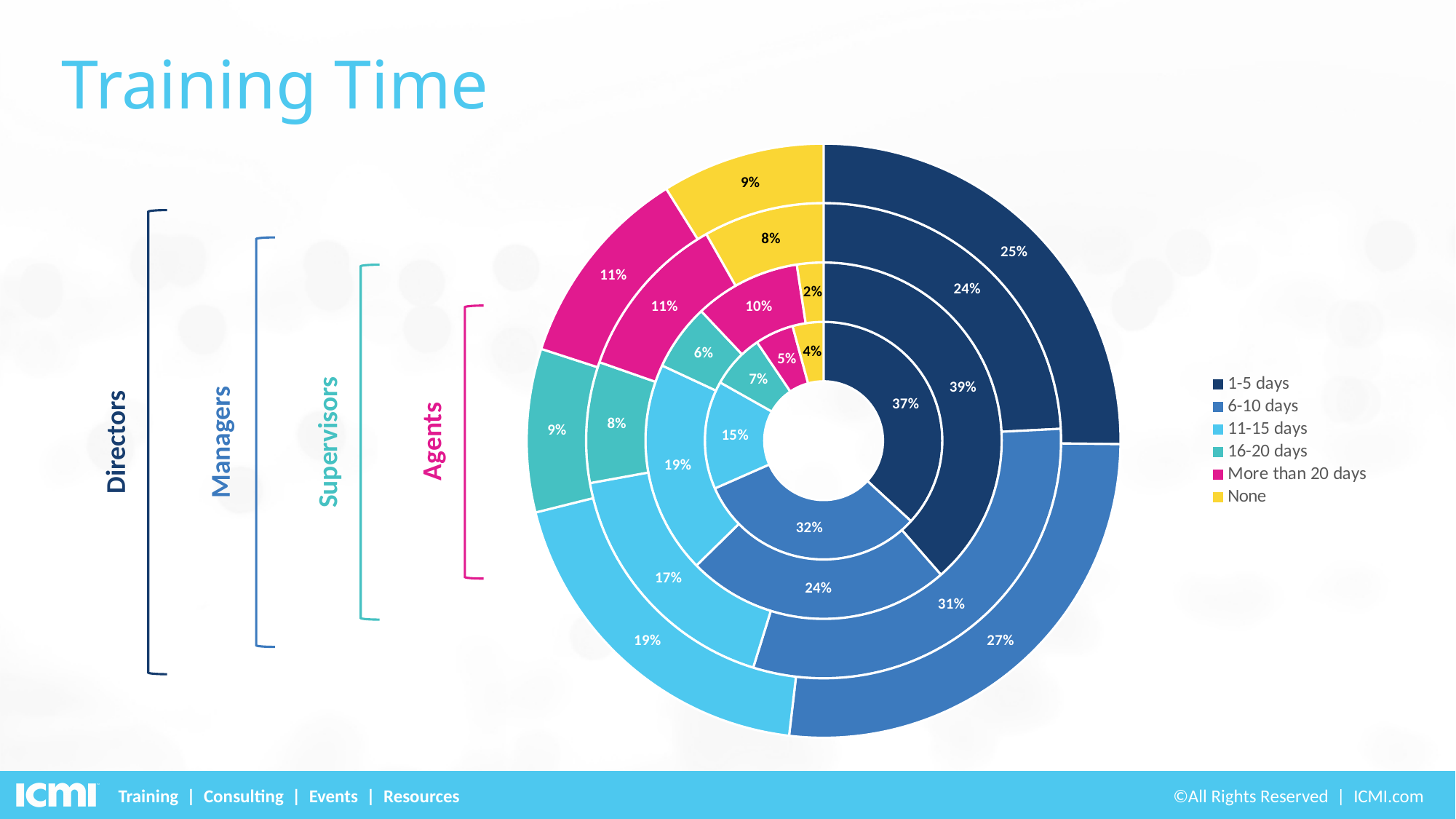
What is the difference between the 1-5 days share for Supervisors and for Directors? 14% What percentage of Managers have more than 20 days of training? 11% Which colour represents the 'None' category in the legend? Yellow Which training-time category has the largest share for Supervisors? 1-5 days What percentage of Supervisors have no training (None)? 2% Which is larger for Managers: the 6-10 days share or the 1-5 days share? 6-10 days What kind of chart is shown on the slide? Doughnut chart Which training-time category has the smallest share for Agents? None What is the title of the slide? Training Time What percentage of Agents (innermost ring) have 1-5 days of training? 37% How many entries does the legend list? 6 What percentage of Directors (outermost ring) have 6-10 days of training? 27%